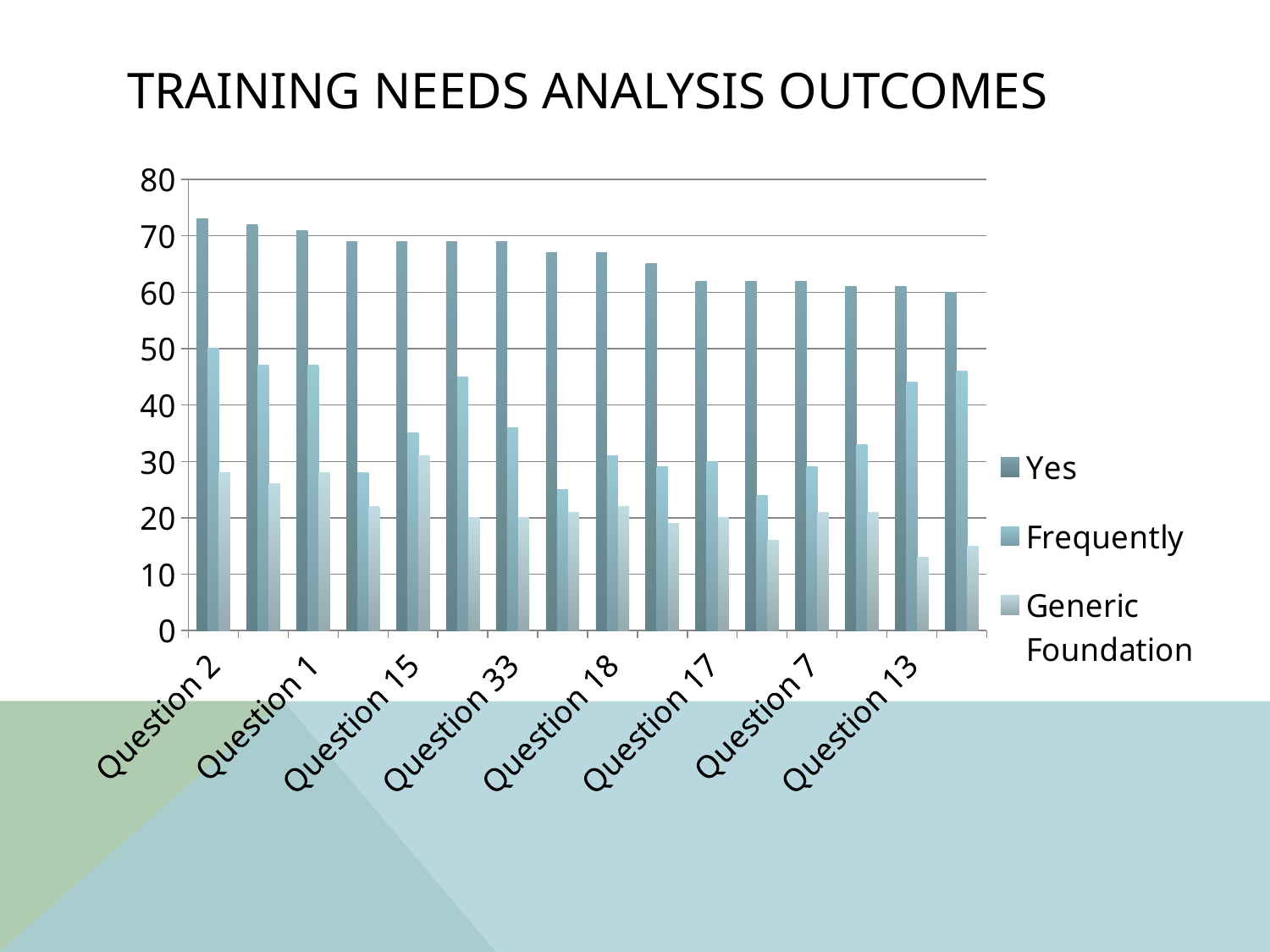
How many series does the legend list? 3 For Question 13, which is larger: the Frequently value or the Generic Foundation value? Frequently Do the values for the Yes series rise or fall from left to right along the x axis? fall What are the three series named in the legend? Yes, Frequently, Generic Foundation Is the Frequently value for Question 15 greater or less than 30? greater What kind of chart is shown on the slide? bar chart For Question 2, which is larger: the Yes value or the Frequently value? Yes Is the Frequently value for Question 13 greater or less than 40? greater Is the Generic Foundation value for Question 13 greater or less than 20? less